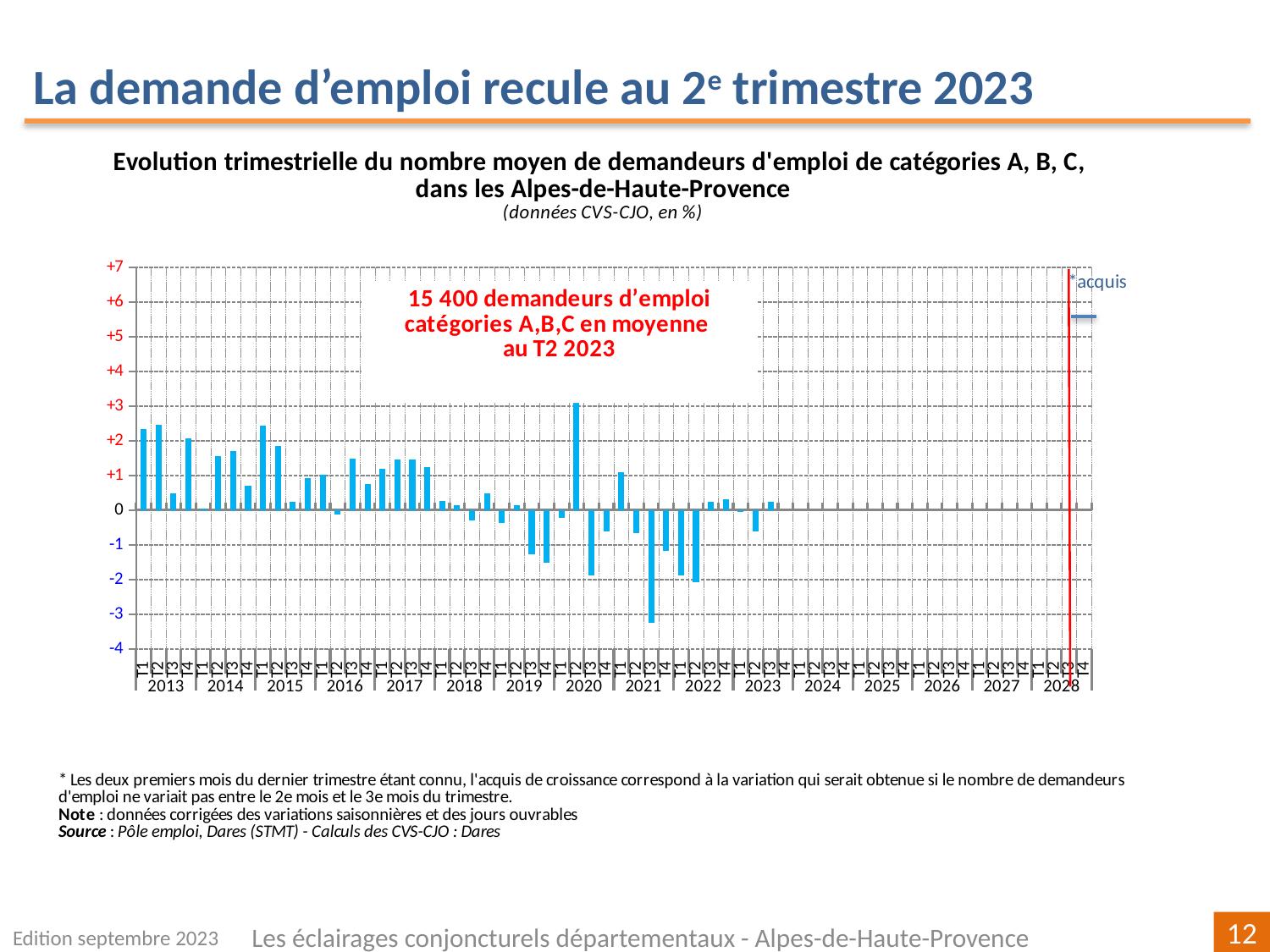
Which quarter has the lowest value on the chart? T3 2021 Is the value for T1 2013 greater or less than +2? greater How many years are labelled along the horizontal axis? 16 What is the highest value shown on the vertical axis? +7 Which is larger, the value for T2 2020 or the value for T3 2021? T2 2020 Is the value for T2 2020 greater or less than +2? greater Which is larger, the value for T1 2013 or the value for T3 2013? T1 2013 Is the value for T1 2022 greater or less than -1? less According to the annotation on the chart, how many demandeurs d'emploi of categories A, B, C were there on average in T2 2023? 15 400 Which quarter has the highest value on the chart? T2 2020 What kind of chart is shown on the slide? bar chart